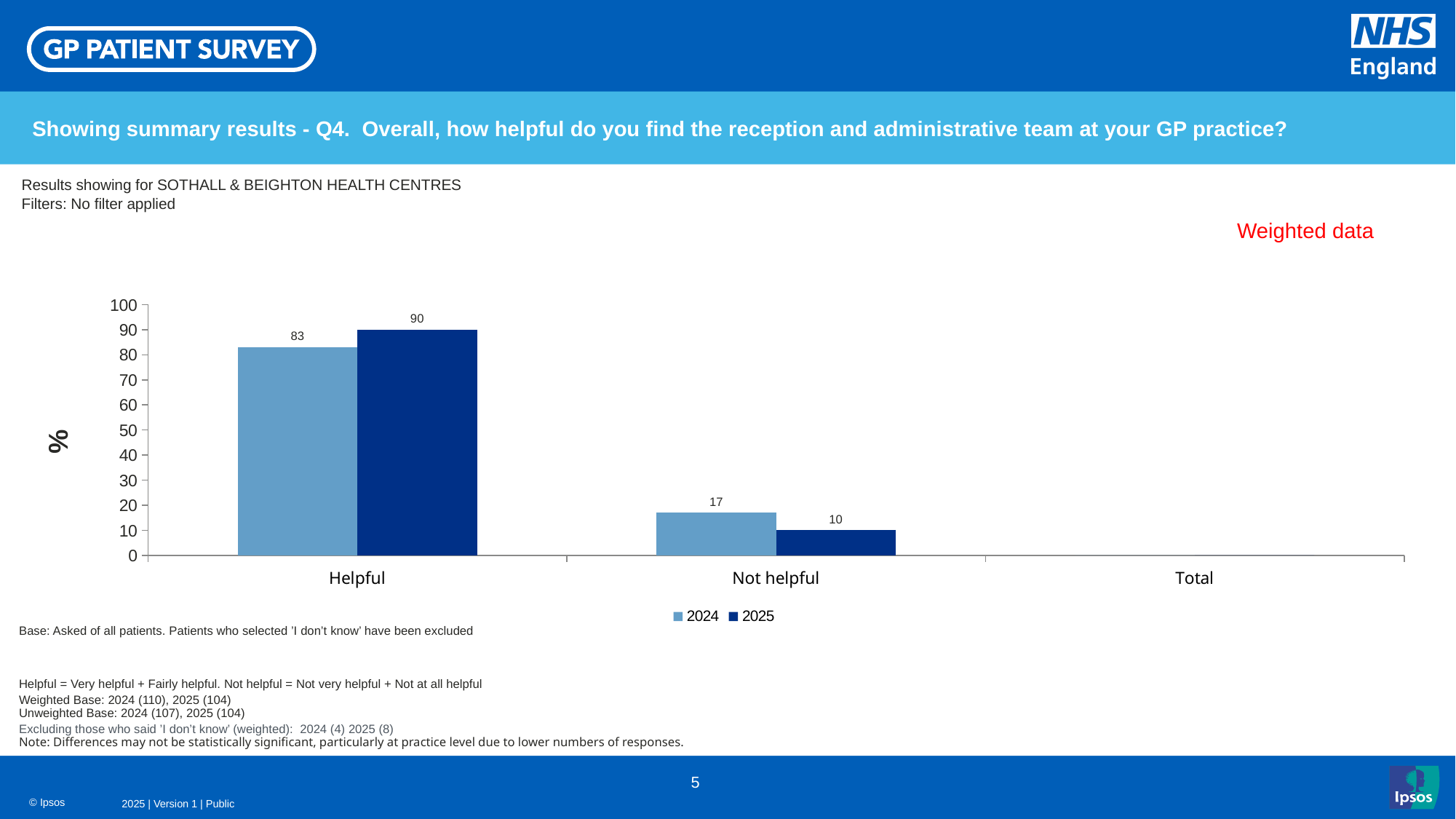
Which category has the highest value in the 2025 series? Helpful What is the value for Not helpful in 2024? 17 What is the difference between the 2025 and 2024 values for Helpful? 7 What kind of chart is shown on the slide? Bar chart Which is larger for Not helpful: the 2024 value or the 2025 value? 2024 What is the value for Helpful in 2024? 83 What is the difference between the 2024 and 2025 values for Not helpful? 7 What is the value for Not helpful in 2025? 10 Which category has the lowest value in the 2024 series? Not helpful How many series does the legend list? 2 What is the value for Helpful in 2025? 90 What label is shown on the vertical axis of the chart? %